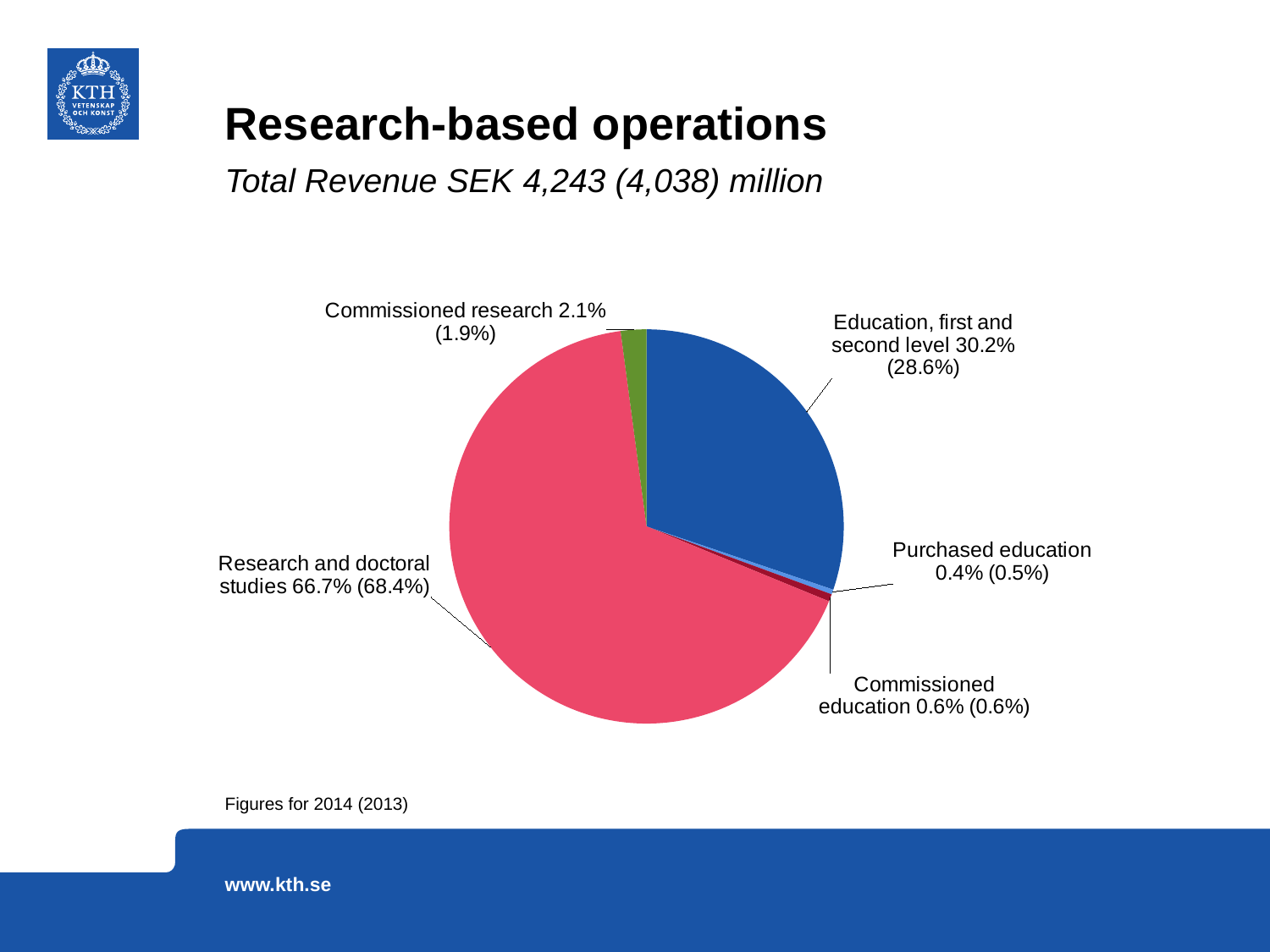
Which category has the smallest slice of the pie? Purchased education What is the 2014 value for Commissioned research? 2.1% Which category has the largest slice of the pie? Research and doctoral studies What share of the pie is Education, first and second level for 2014? 30.2% Which is larger in 2014: Commissioned research or Commissioned education? Commissioned research What kind of chart is shown on the slide? Pie chart What total revenue is stated in the slide subtitle? SEK 4,243 (4,038) million What share of the pie is Research and doctoral studies for 2014? 66.7% What is the difference between the 2014 shares of Research and doctoral studies and Education, first and second level? 36.5% What was the 2013 value (in parentheses) for Research and doctoral studies? 68.4% How many slices does the pie chart have? 5 What is the 2014 value for Purchased education? 0.4%